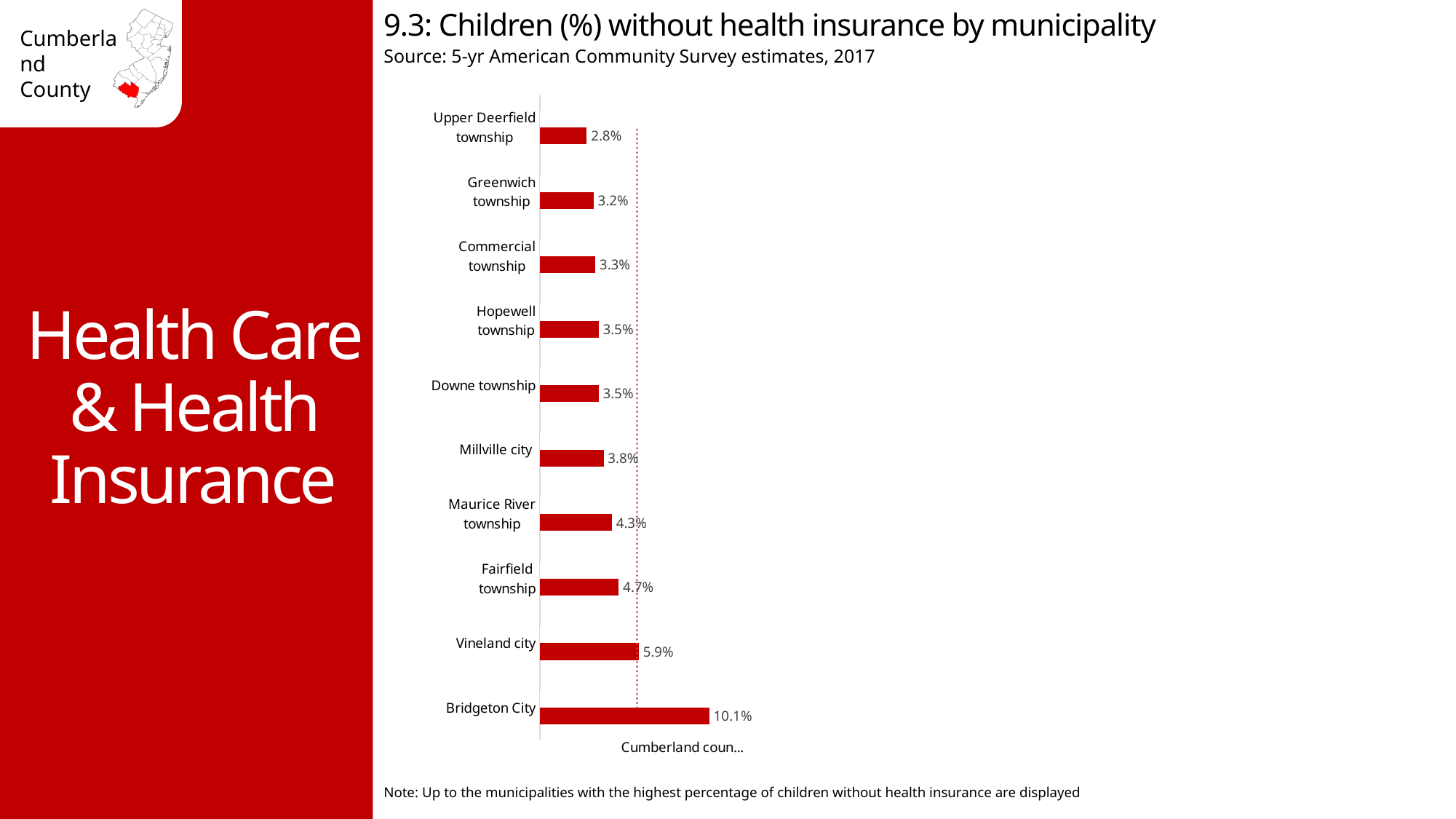
What is the value shown for Vineland city? 5.9% Which has a higher value, Millville city or Fairfield township? Fairfield township What percentage of children are without health insurance in Bridgeton City? 10.1% Which municipality has the highest percentage of children without health insurance? Bridgeton City What is the difference between the values for Bridgeton City and Vineland city? 4.2% Which municipality has the lowest percentage of children without health insurance? Upper Deerfield township What is the value for Upper Deerfield township? 2.8% What percentage is shown for Maurice River township? 4.3% How many municipalities are shown in the chart? 10 What kind of chart is shown on the slide? Bar chart What is the difference between the values for Fairfield township and Greenwich township? 1.5% What is the title of the chart? 9.3: Children (%) without health insurance by municipality